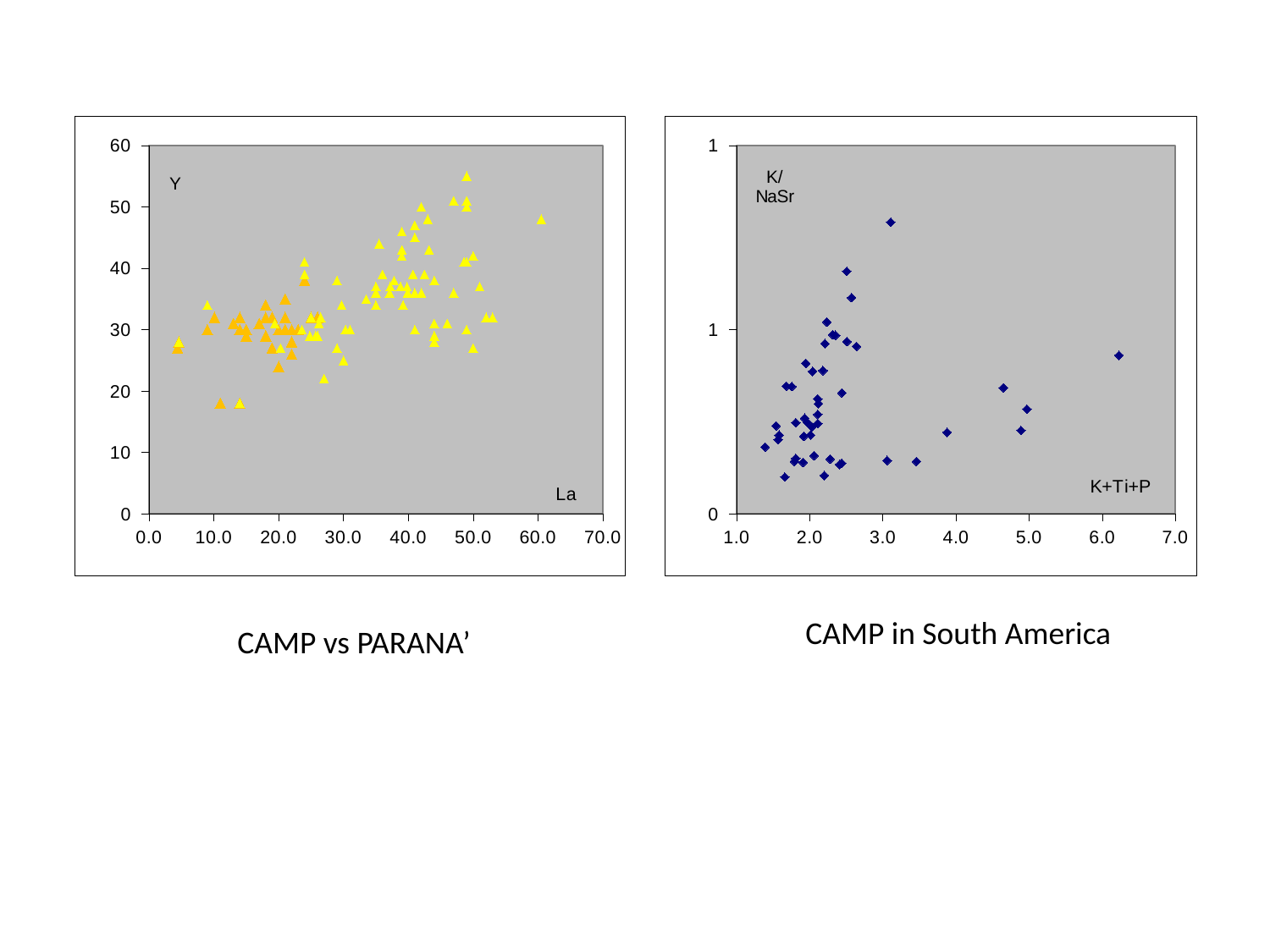
In the 'CAMP in South America' chart, is the K+Ti+P value of the rightmost point greater or less than 6.0? greater In the 'CAMP in South America' chart, what is the label on the horizontal axis? K+Ti+P In the 'CAMP vs PARANA'' chart, do the Y values generally rise or fall as La increases? rise In the 'CAMP vs PARANA'' chart, is the Y value of the lowest point greater or less than 20? less In the 'CAMP in South America' chart, is the K/NaSr value of the rightmost point (near K+Ti+P = 6.2) greater or less than 1? less What kind of chart is the 'CAMP in South America' chart on the right? scatter chart What kind of chart is the 'CAMP vs PARANA'' chart on the left? scatter chart In the 'CAMP vs PARANA'' chart, what is the label on the horizontal axis? La In the 'CAMP vs PARANA'' chart, what is the maximum value shown on the horizontal axis? 70.0